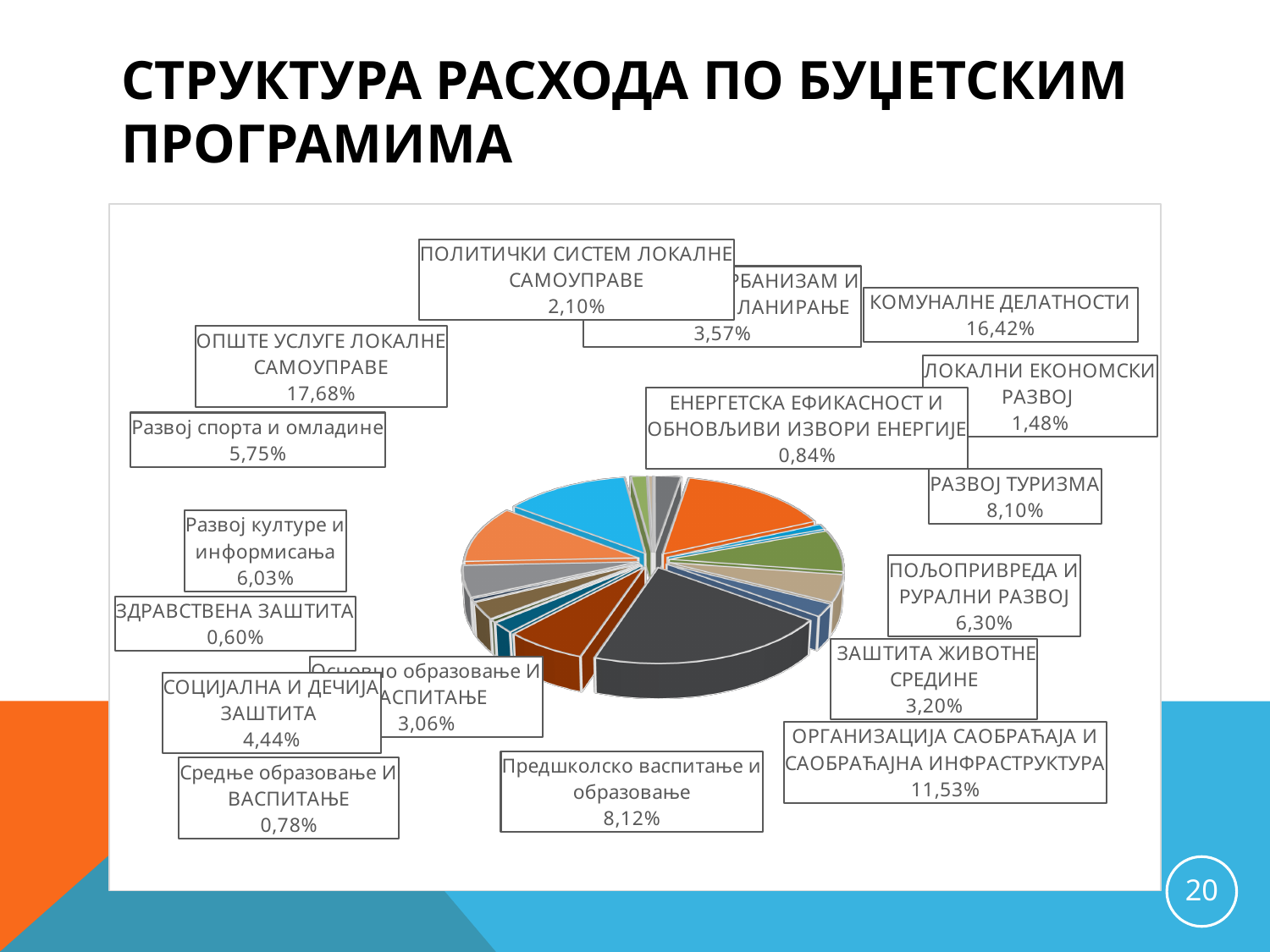
Which budget programme has the smallest share of expenditure? ЗДРАВСТВЕНА ЗАШТИТА What share is shown for ЕНЕРГЕТСКА ЕФИКАСНОСТ И ОБНОВЉИВИ ИЗВОРИ ЕНЕРГИЈЕ? 0,84% Which budget programme has the largest share of expenditure? ОПШТЕ УСЛУГЕ ЛОКАЛНЕ САМОУПРАВЕ How many budget programmes are labelled on the pie chart? 17 What is the difference in percentage points between ОРГАНИЗАЦИЈА САОБРАЋАЈА И САОБРАЋАЈНА ИНФРАСТРУКТУРА and РАЗВОЈ ТУРИЗМА? 3,43 What share of expenditure goes to КОМУНАЛНЕ ДЕЛАТНОСТИ? 16,42% What is the title of the slide containing the chart? СТРУКТУРА РАСХОДА ПО БУЏЕТСКИМ ПРОГРАМИМА By how many percentage points does ОПШТЕ УСЛУГЕ ЛОКАЛНЕ САМОУПРАВЕ exceed КОМУНАЛНЕ ДЕЛАТНОСТИ? 1,26 What kind of chart is shown on the slide? Pie chart Which has a larger share: ПОЉОПРИВРЕДА И РУРАЛНИ РАЗВОЈ or Развој културе и информисања? ПОЉОПРИВРЕДА И РУРАЛНИ РАЗВОЈ What is the value shown for ОРГАНИЗАЦИЈА САОБРАЋАЈА И САОБРАЋАЈНА ИНФРАСТРУКТУРА? 11,53% What percentage is labelled for РАЗВОЈ ТУРИЗМА? 8,10%